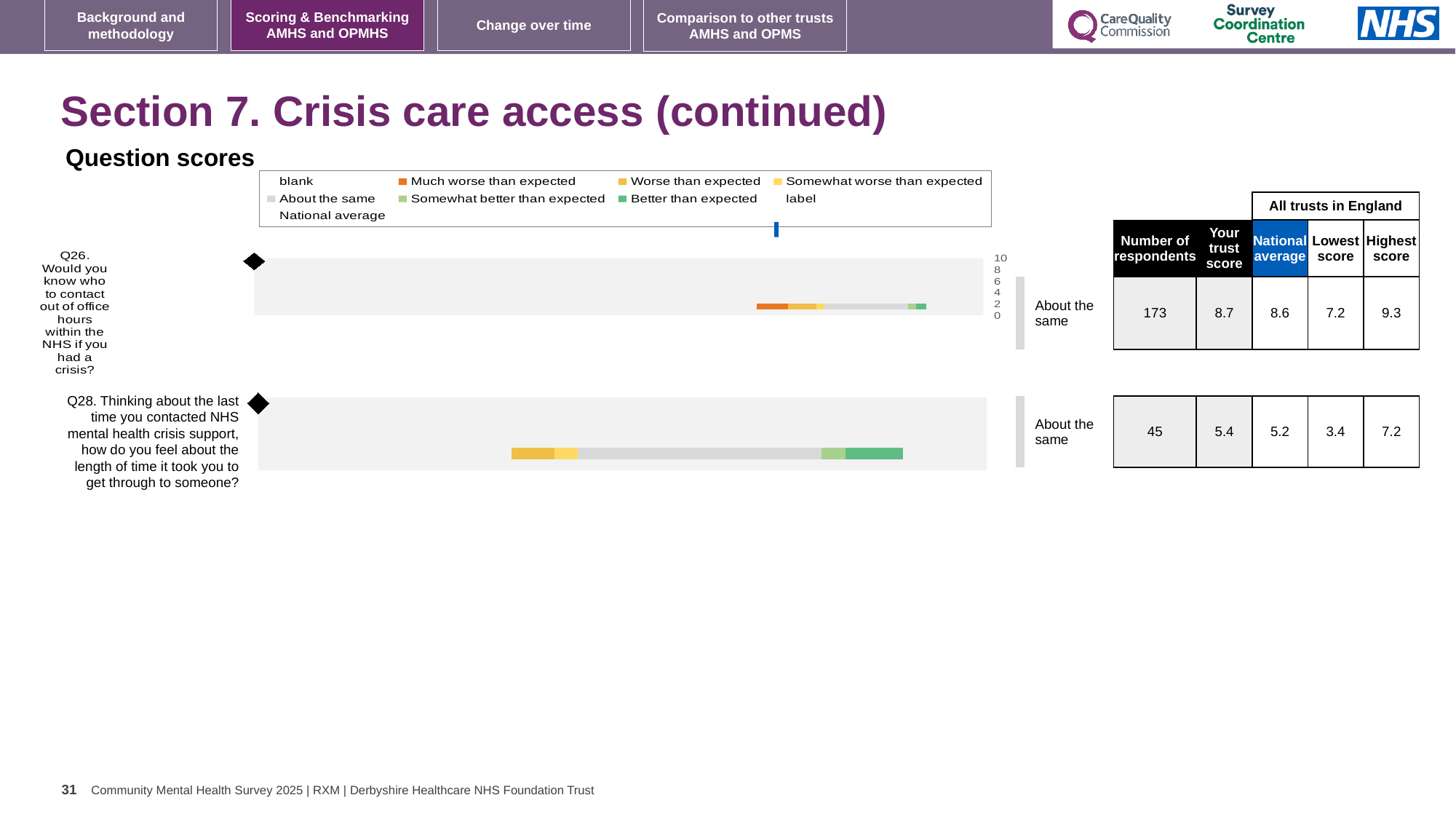
What is the trust score for Q26 (knowing who to contact out of office hours in a crisis)? 8.7 Which is larger for Q26: the trust score or the national average? trust score What is the national average score for Q26? 8.6 Which question has the higher trust score, Q26 or Q28? Q26 What is the highest tick value shown on the score axis of the chart? 10 What kind of chart is used to show the question scores on this slide? bar chart What is the difference between the trust score and the national average for Q26? 0.1 How many respondents answered Q28? 45 What benchmark category is shown next to the Q28 bar? About the same What is the difference between the highest score and the lowest score for Q28 across all trusts in England? 3.8 What is the trust score for Q28 (length of time to get through to crisis support)? 5.4 How many questions (Q26 and Q28) are plotted as bars on this slide? 2